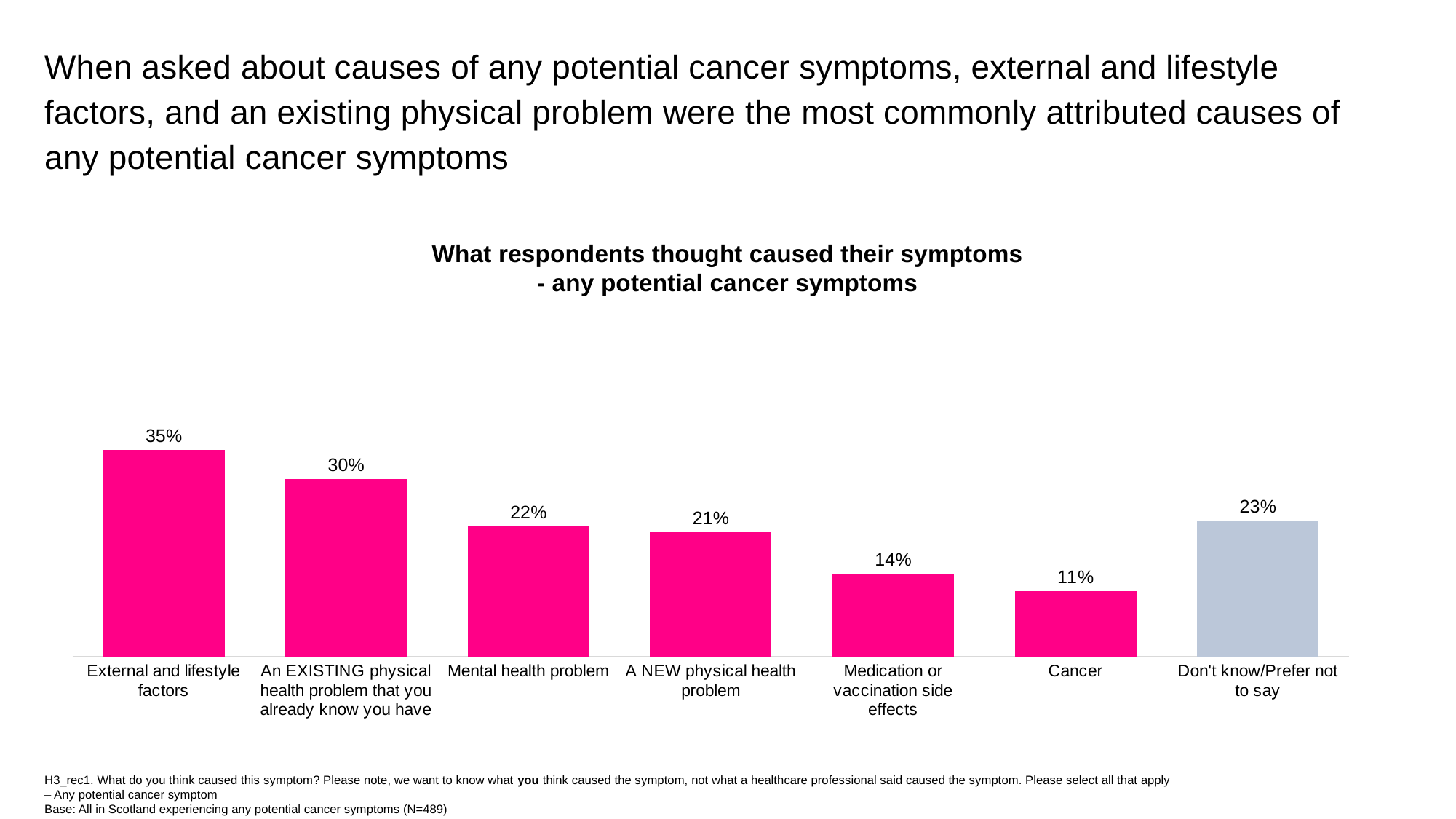
Which bar is shown in a different colour from the others? Don't know/Prefer not to say Which category has the lowest value? Cancer What is the difference between the values for External and lifestyle factors and An EXISTING physical health problem that you already know you have? 5% What type of chart is shown on the slide? Bar chart What percentage of respondents answered Don't know/Prefer not to say? 23% Which is larger: the value for Don't know/Prefer not to say or the value for A NEW physical health problem? Don't know/Prefer not to say What is the value for Medication or vaccination side effects? 14% What is the difference between the values for Mental health problem and Cancer? 11% What is the value for Cancer? 11% Which category has the highest value? External and lifestyle factors How many categories are shown in the chart? 7 What percentage of respondents attributed their symptoms to external and lifestyle factors? 35%